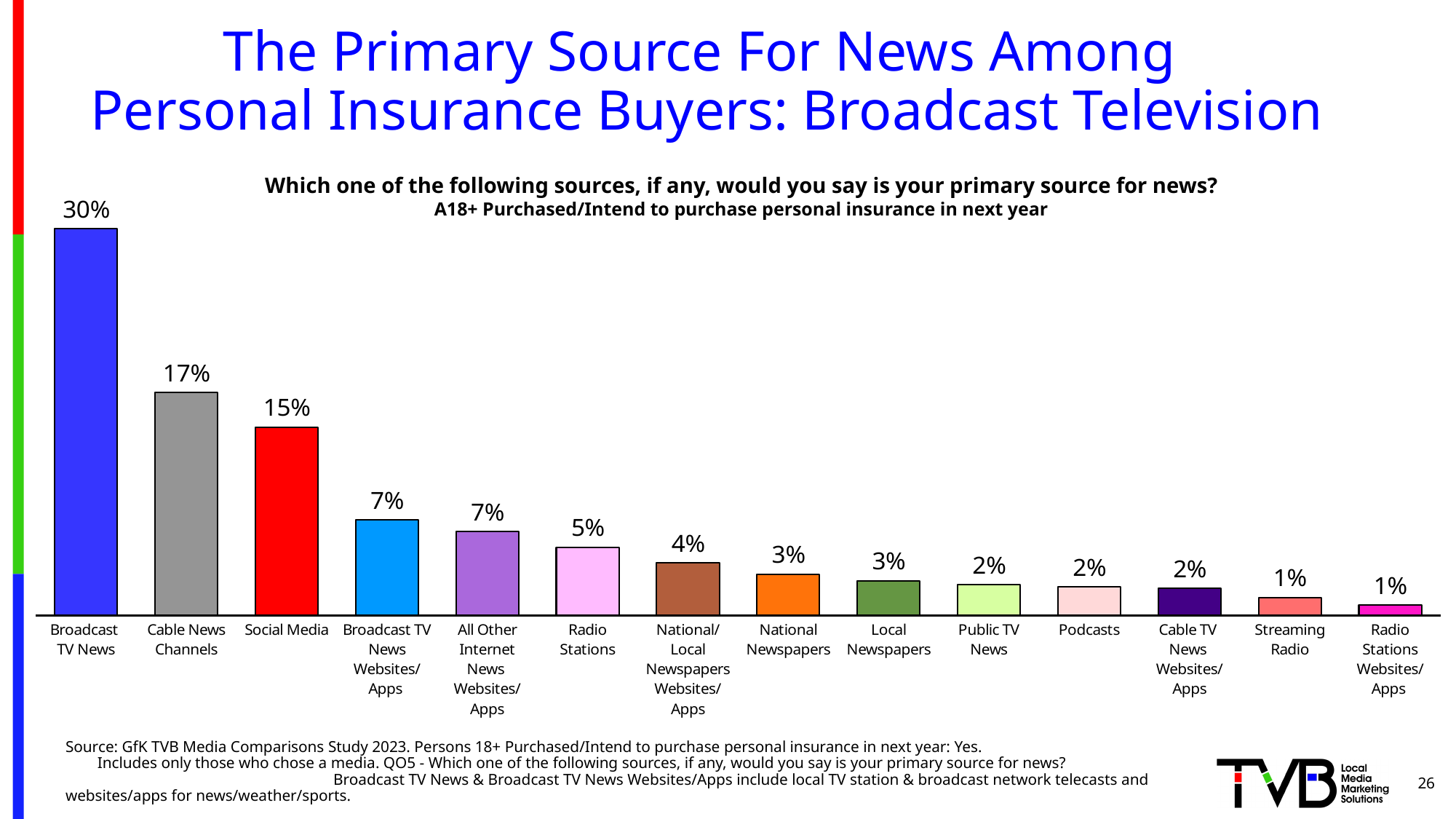
What is the lowest value shown in the chart? 1% Which has a larger value, Social Media or Radio Stations? Social Media What kind of chart is shown on the slide? Bar chart What percentage of personal insurance buyers say Broadcast TV News is their primary source for news? 30% Do the values rise or fall moving from left to right across the chart? Fall What is the value shown for Podcasts? 2% What is the value shown for Cable News Channels? 17% What is the difference between the values for Broadcast TV News and Cable News Channels? 13 percentage points What is the value shown for Social Media? 15% What is the value shown for Radio Stations? 5% Which news source has the highest value in the chart? Broadcast TV News How many news source categories are shown in the chart? 14